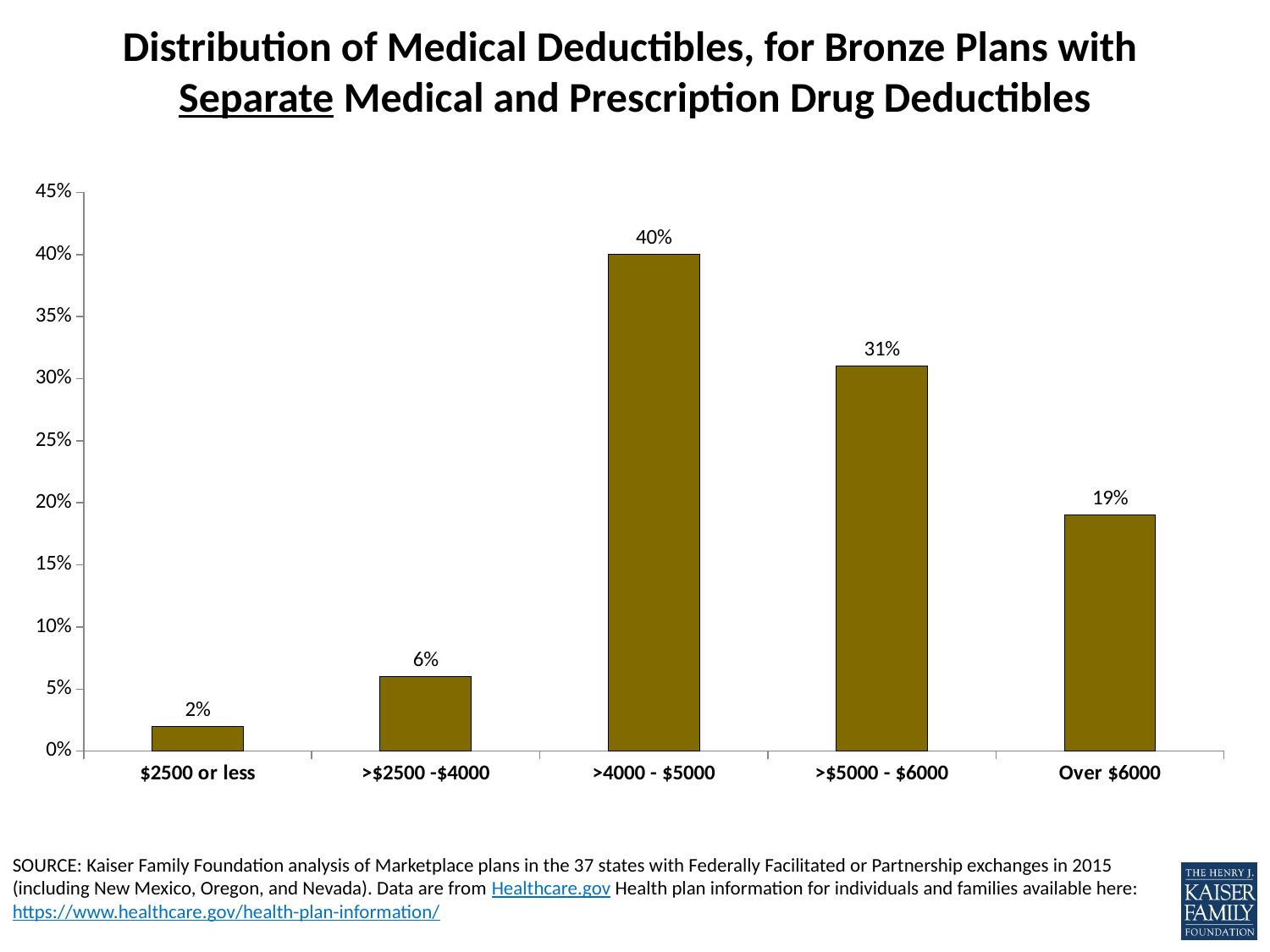
What is the value shown for the >$2500 -$4000 category? 6% What is the difference in percentage points between the >4000 - $5000 and >$5000 - $6000 categories? 9 percentage points Which deductible range has the lowest share of plans? $2500 or less How many deductible categories are shown on the x axis? 5 What is the highest value labelled on the y axis? 45% Which deductible range has the highest share of plans? >4000 - $5000 Which is larger, the value for Over $6000 or the value for >$2500 -$4000? Over $6000 What type of chart is shown on the slide? Bar chart What percentage is shown for the >$5000 - $6000 deductible range? 31% What percentage of bronze plans with separate deductibles have a medical deductible of $2500 or less? 2% Is the value for >$5000 - $6000 greater or less than 30%? greater What is the value for the Over $6000 category? 19%